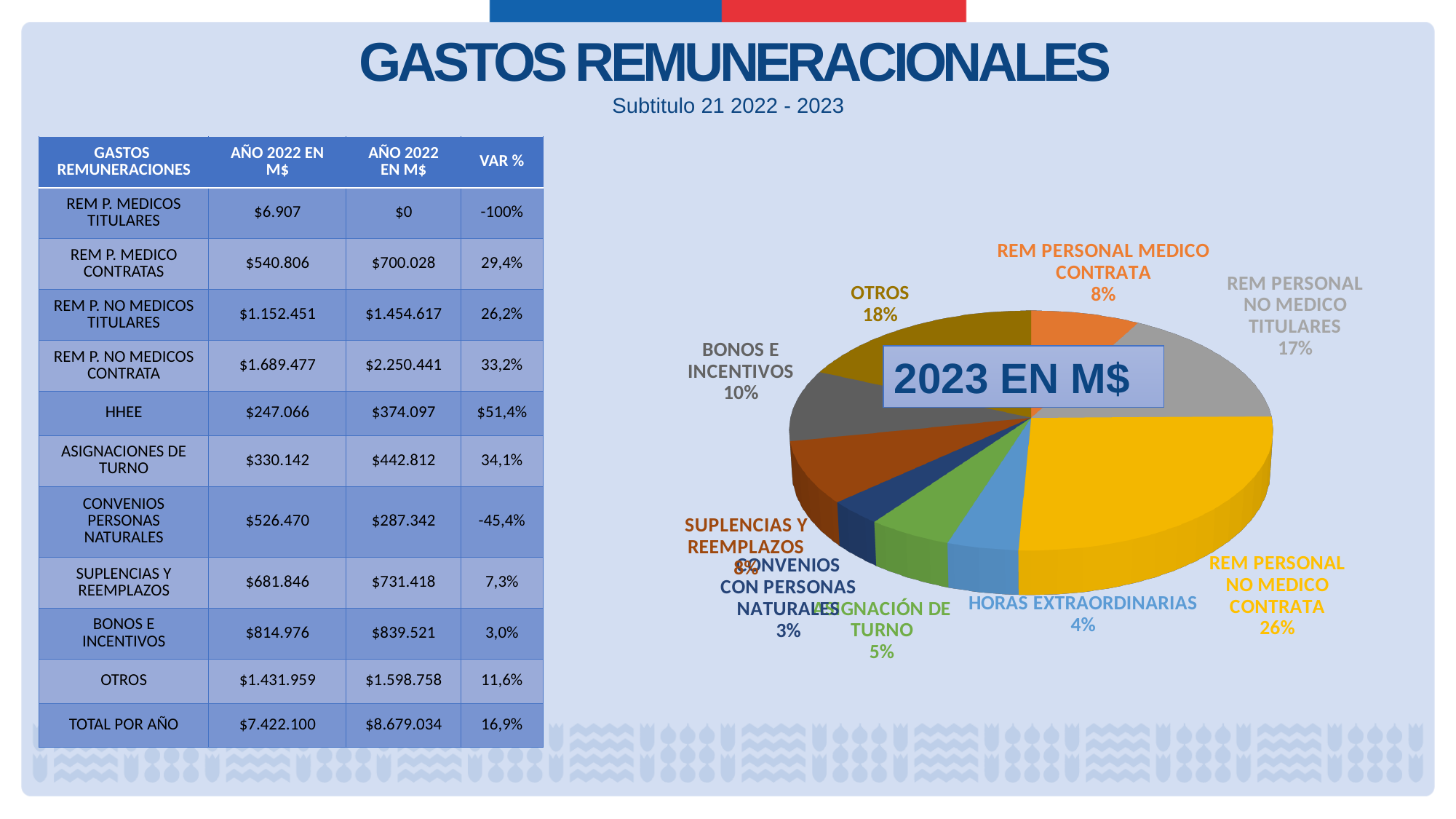
How many slices does the pie chart have? 9 What share of the pie does OTROS represent? 18% What share of the pie does BONOS E INCENTIVOS represent? 10% What is the difference in percentage points between REM PERSONAL NO MEDICO CONTRATA and ASIGNACIÓN DE TURNO? 21 percentage points What share of the pie does REM PERSONAL NO MEDICO CONTRATA represent? 26% What is the title shown on the pie chart? 2023 EN M$ Which category has the largest slice of the pie? REM PERSONAL NO MEDICO CONTRATA What kind of chart is shown on the slide? Pie chart Which is larger in the pie chart, OTROS or REM PERSONAL NO MEDICO TITULARES? OTROS Which category has the smallest slice of the pie? CONVENIOS CON PERSONAS NATURALES